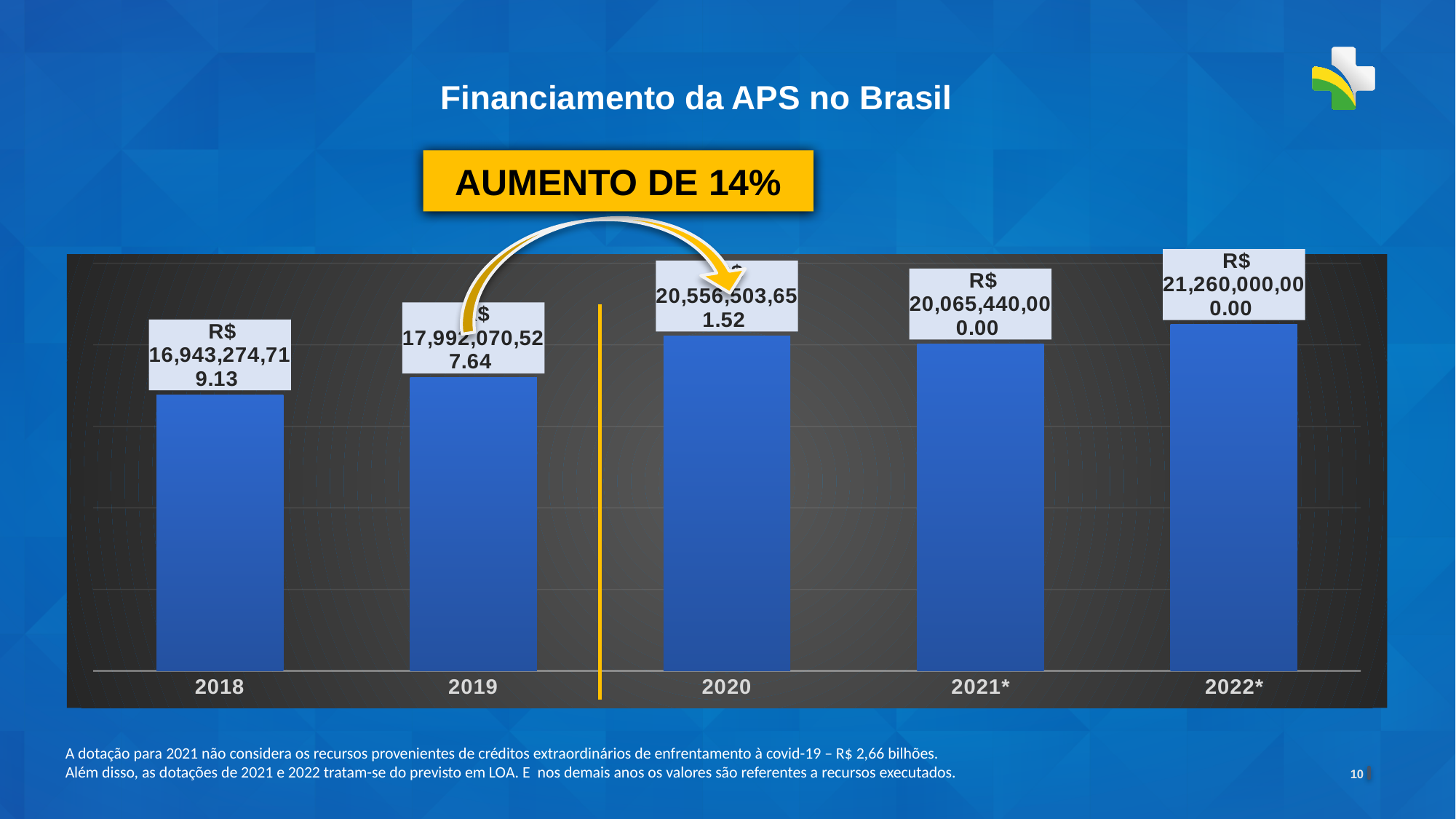
Which is larger, the value for 2020 or the value for 2021*? 2020 What is the value for 2018? R$ 16,943,274,719.13 What is the difference between the values for 2022* and 2021*? R$ 1,194,560,000.00 How many years (bars) are shown in the chart? 5 What is the value for 2022*? R$ 21,260,000,000.00 Which year has the lowest value? 2018 What type of chart is shown on the slide? bar chart What is the value for 2021*? R$ 20,065,440,000.00 Which year has the highest value? 2022* What percentage increase is highlighted in the yellow box above the chart? 14% What is the title of the chart? Financiamento da APS no Brasil What is the value for 2020? R$ 20,556,503,651.52